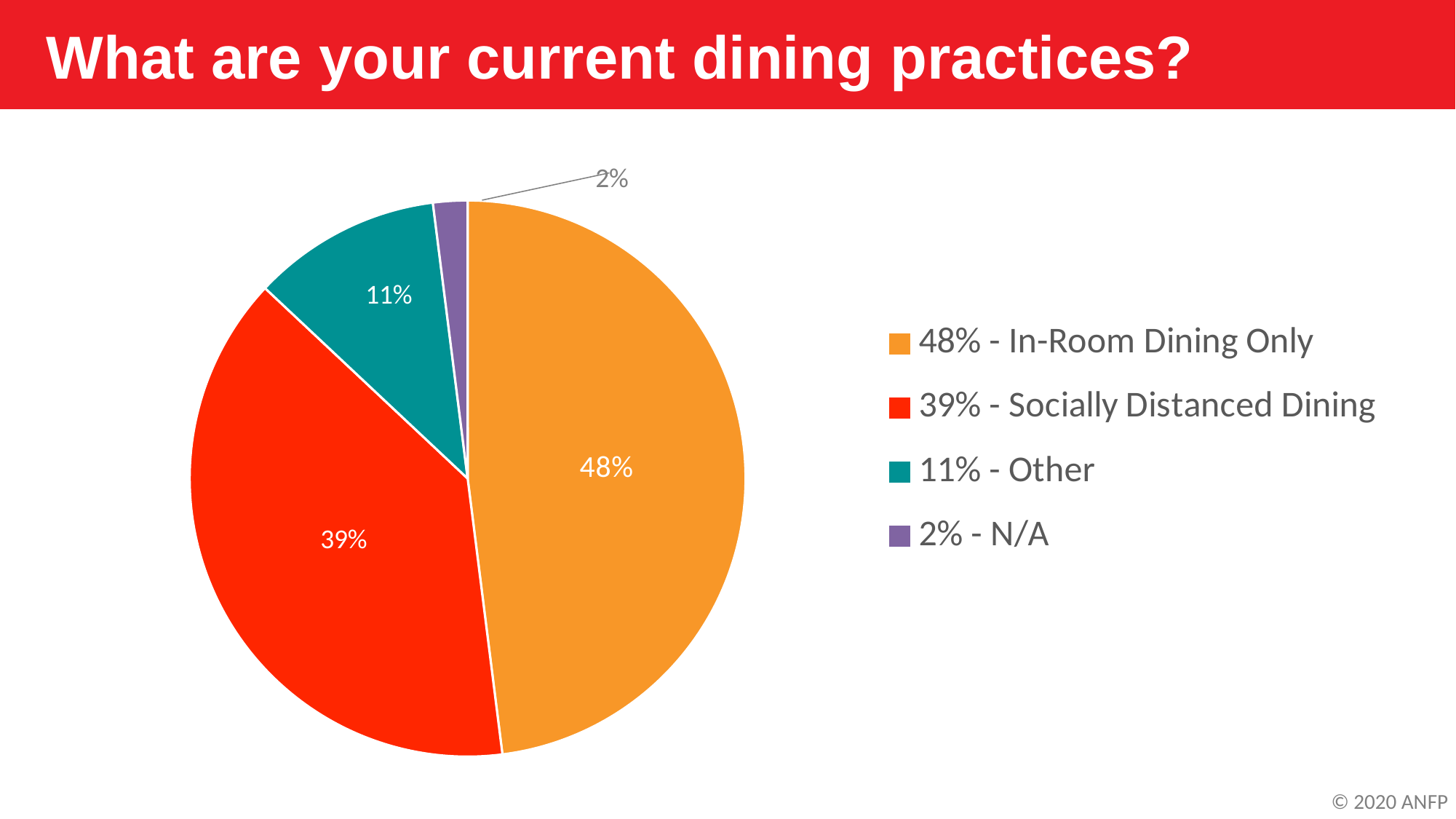
What is the difference between In-Room Dining Only and Socially Distanced Dining? 9% Which category has the largest slice? In-Room Dining Only How many categories does the pie chart have? 4 What kind of chart is shown on the slide? pie chart What is the value for Other? 11% What share of the pie is In-Room Dining Only? 48% Which is larger, Socially Distanced Dining or Other? Socially Distanced Dining What is the difference between Other and N/A? 9% What share of the pie is Socially Distanced Dining? 39% Which category has the smallest slice? N/A What is the value for N/A? 2% What colour is the slice for Other? teal